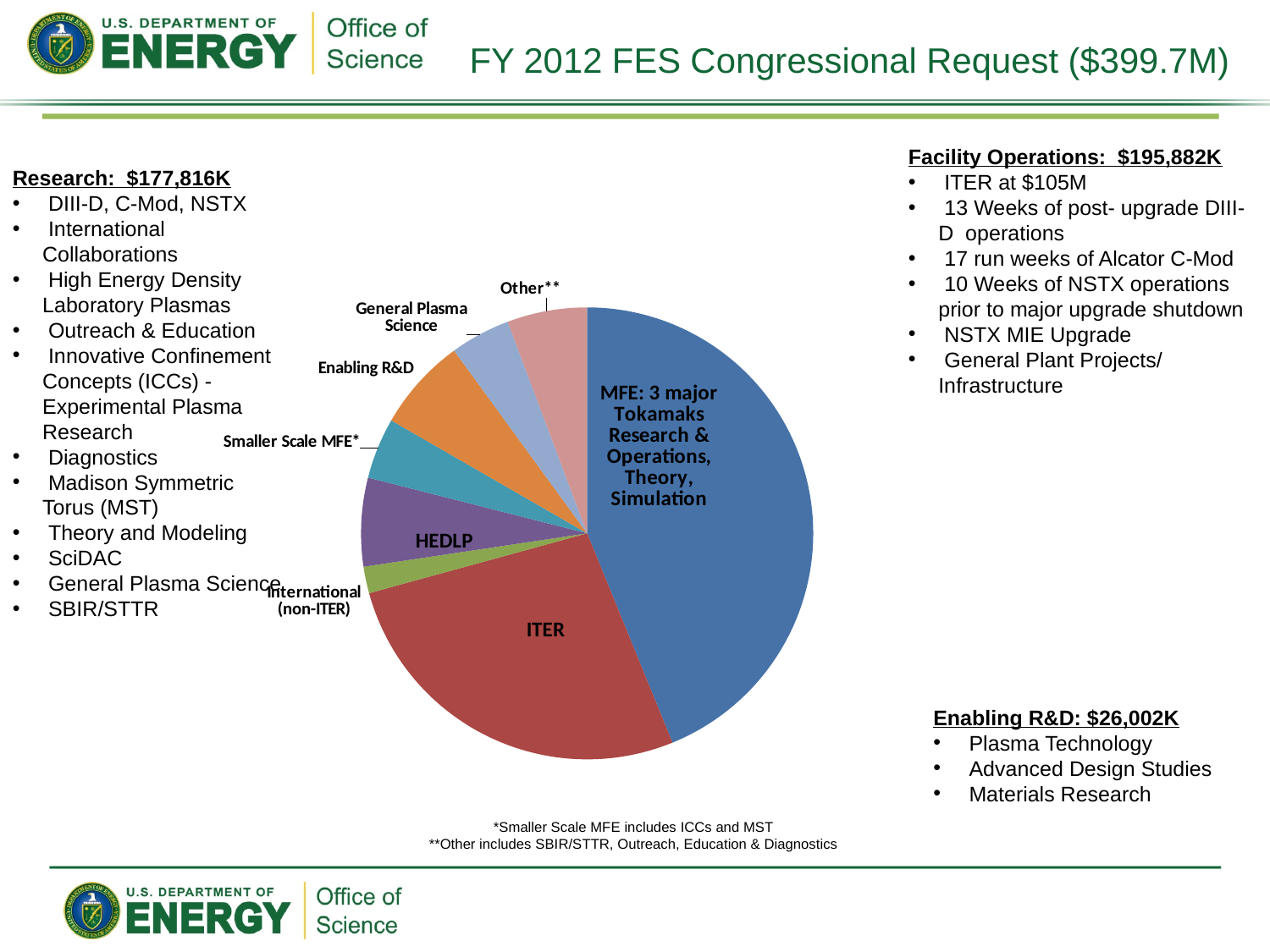
Which slice of the pie chart is the largest? MFE: 3 major Tokamaks Research & Operations, Theory, Simulation According to the footnote, what does Smaller Scale MFE include? ICCs and MST Which slice is larger in the pie chart, HEDLP or International (non-ITER)? HEDLP Which slice is larger in the pie chart, MFE: 3 major Tokamaks Research & Operations, Theory, Simulation or ITER? MFE: 3 major Tokamaks Research & Operations, Theory, Simulation Which slice of the pie chart is the smallest? International (non-ITER) Which slice is larger in the pie chart, ITER or HEDLP? ITER What kind of chart is shown on the slide? pie chart How many slices does the pie chart have? 8 What colour is the ITER slice in the pie chart? red